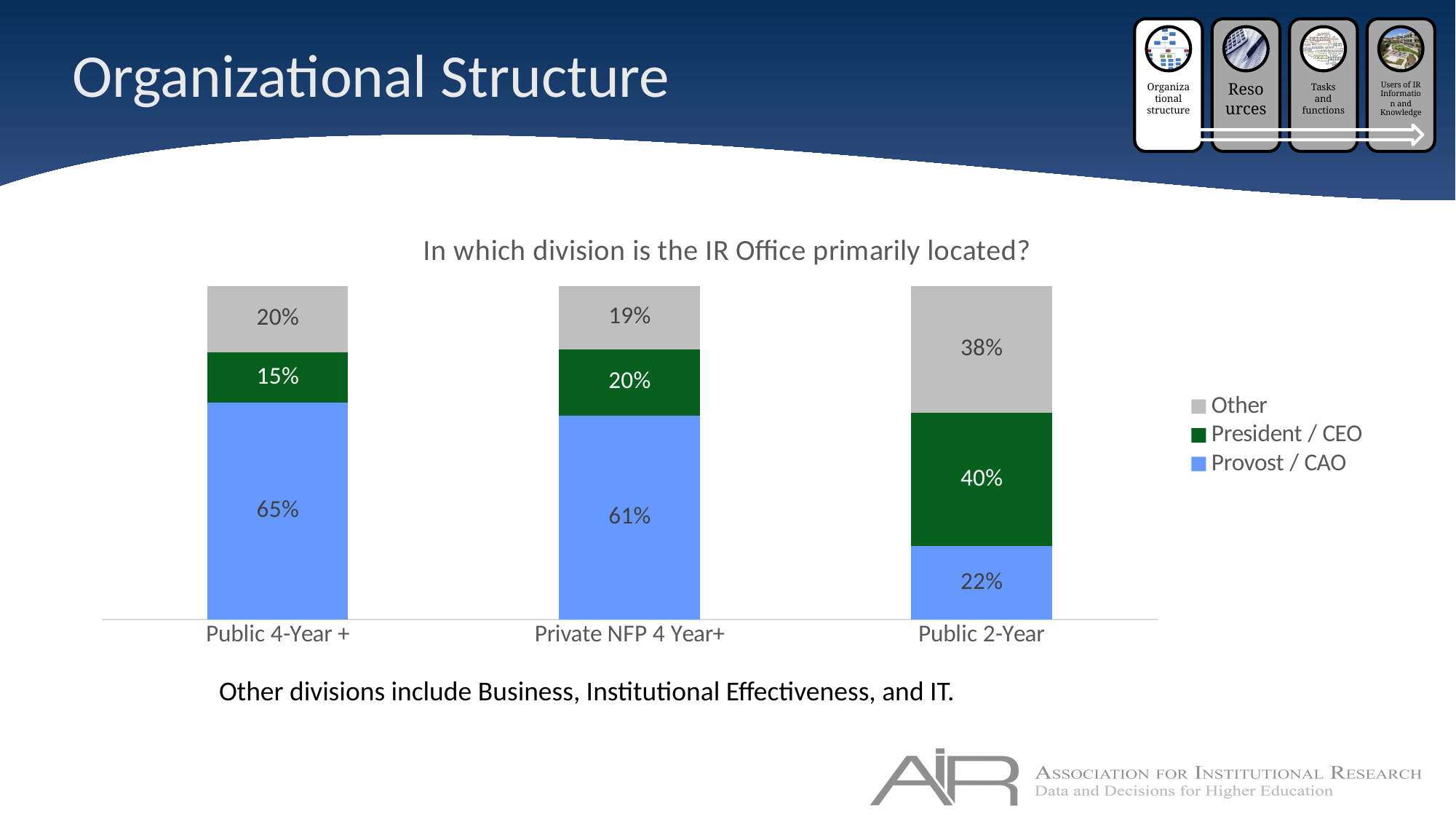
How many series does the legend list? 3 What is the Other value for Private NFP 4 Year+ institutions? 19% What is the title of the chart? In which division is the IR Office primarily located? What is the Provost / CAO value for Public 2-Year institutions? 22% Which institution type has the highest Provost / CAO percentage? Public 4-Year + What percentage of Public 4-Year + institutions have the IR Office located under the Provost / CAO? 65% Which is larger: the Provost / CAO value for Private NFP 4 Year+ or for Public 2-Year? Private NFP 4 Year+ What is the difference between the Other percentage for Public 2-Year and for Public 4-Year +? 18% How many institution types are shown on the x axis? 3 Which institution type has the lowest President / CEO percentage? Public 4-Year + What is the President / CEO value for Public 2-Year institutions? 40% What kind of chart is shown on the slide? Stacked bar chart